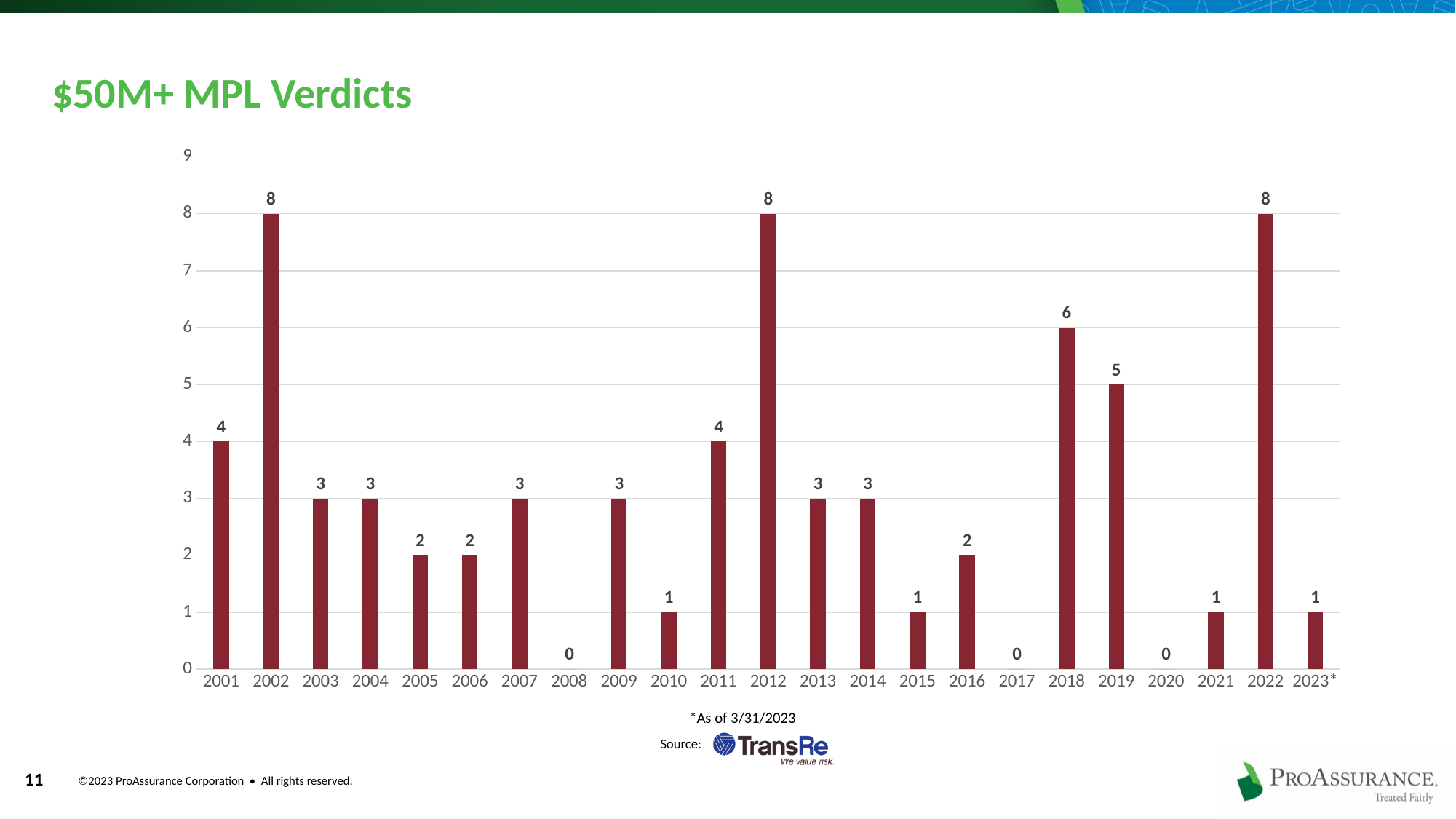
What is the value for 2019? 5 What is the source cited for the chart? TransRe What is the value for 2018? 6 Which is larger, the value for 2001 or the value for 2016? 2001 What is the difference between the values for 2018 and 2019? 1 Which years have a value of 0? 2008, 2017 and 2020 What kind of chart is this? Bar chart What is the value for 2011? 4 What is the difference between the values for 2022 and 2023*? 7 Which years have the highest value? 2002, 2012 and 2022 What is the title of the chart? $50M+ MPL Verdicts How many years are shown on the x axis? 23